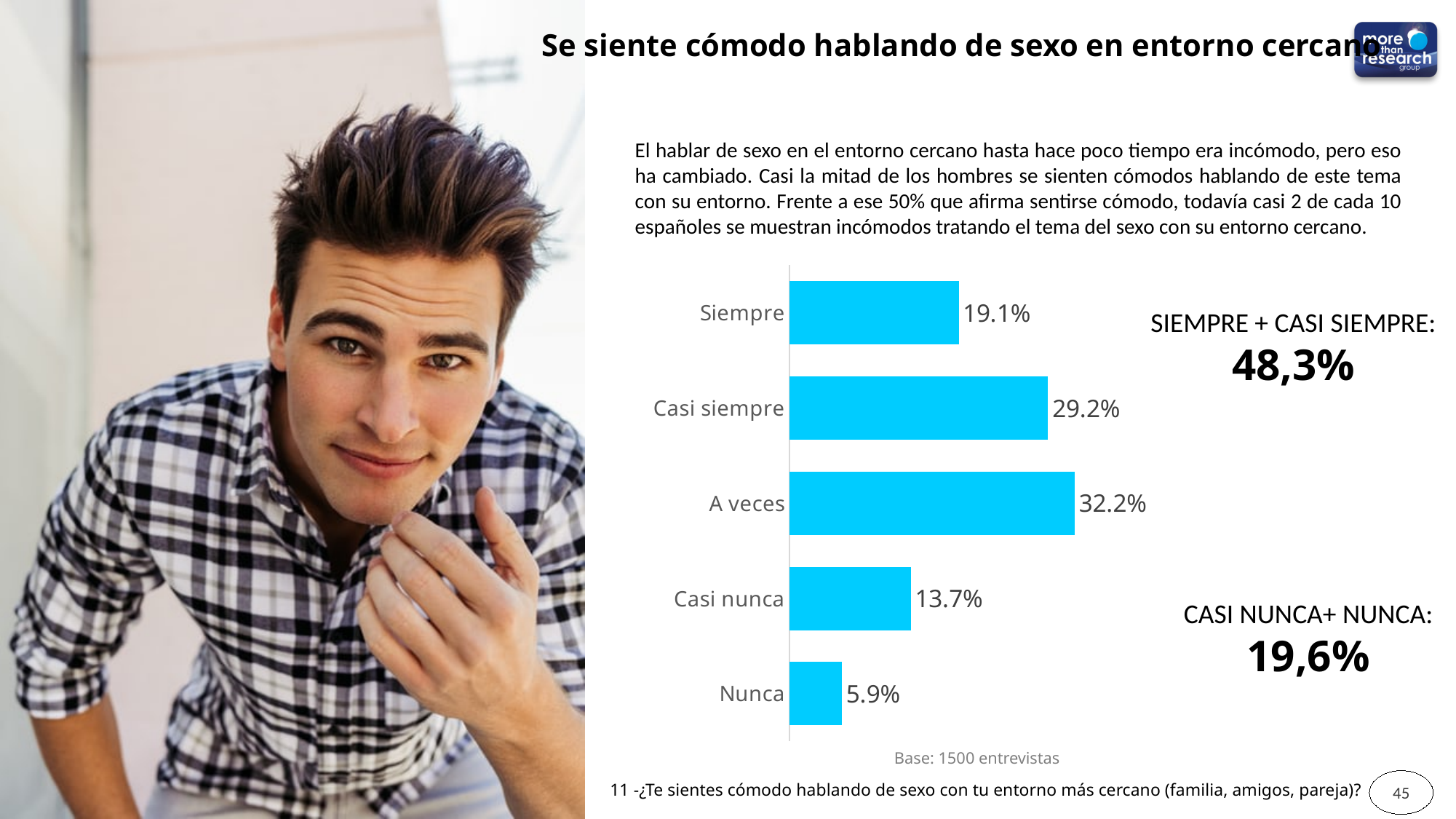
Which is larger, the value for "Casi nunca" or the value for "Nunca"? Casi nunca Which category has the highest value? A veces What is the difference between the values for "Casi siempre" and "Siempre"? 10.1% What is the value for "Siempre"? 19.1% How many categories are shown in the chart? 5 What is the value for "A veces"? 32.2% What base (number of interviews) is stated below the chart? 1500 entrevistas Which category has the lowest value? Nunca What kind of chart is shown on the slide? Bar chart What is the value for "Nunca"? 5.9% What is the value for "Casi siempre"? 29.2% What is the value for "Casi nunca"? 13.7%